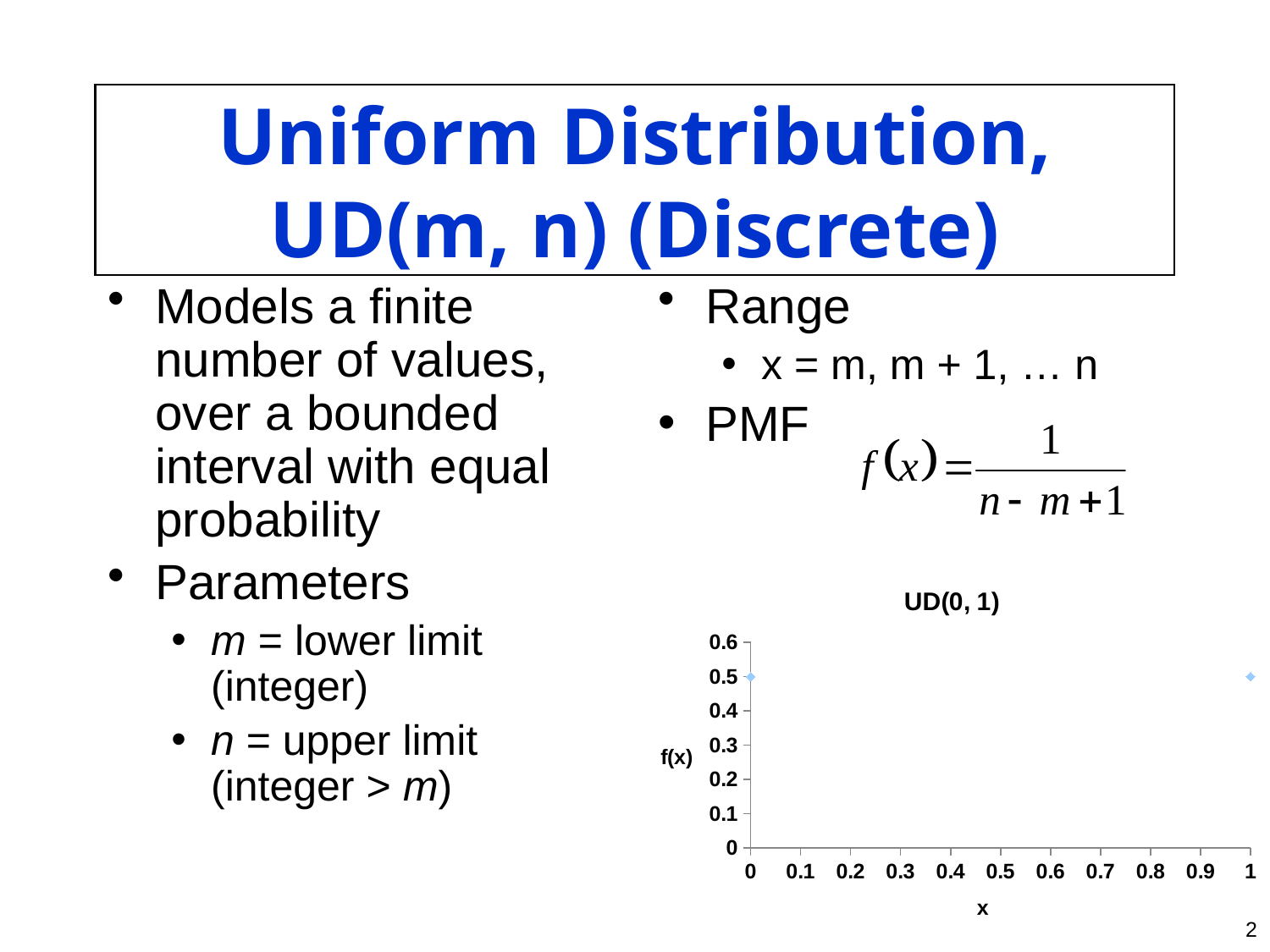
In the UD(0, 1) chart, is the value of f(x) at x = 1 greater or less than 0.4? greater What is the label of the vertical axis in the UD(0, 1) chart? f(x) In the UD(0, 1) chart, do the plotted f(x) values rise, fall, or stay the same from x = 0 to x = 1? stay the same In the UD(0, 1) chart, what is the value of f(x) at x = 0? 0.5 In the UD(0, 1) chart, is the value of f(x) at x = 0 greater or less than 0.6? less What is the largest x value at which a point is plotted in the UD(0, 1) chart? 1 What is the title of the chart on the slide? UD(0, 1) In the UD(0, 1) chart, what is the difference between f(x) at x = 0 and f(x) at x = 1? 0 What is the highest tick value shown on the vertical axis of the UD(0, 1) chart? 0.6 What kind of chart is shown on the slide? scatter chart How many data points are plotted in the UD(0, 1) chart? 2 In the UD(0, 1) chart, what is the value of f(x) at x = 1? 0.5